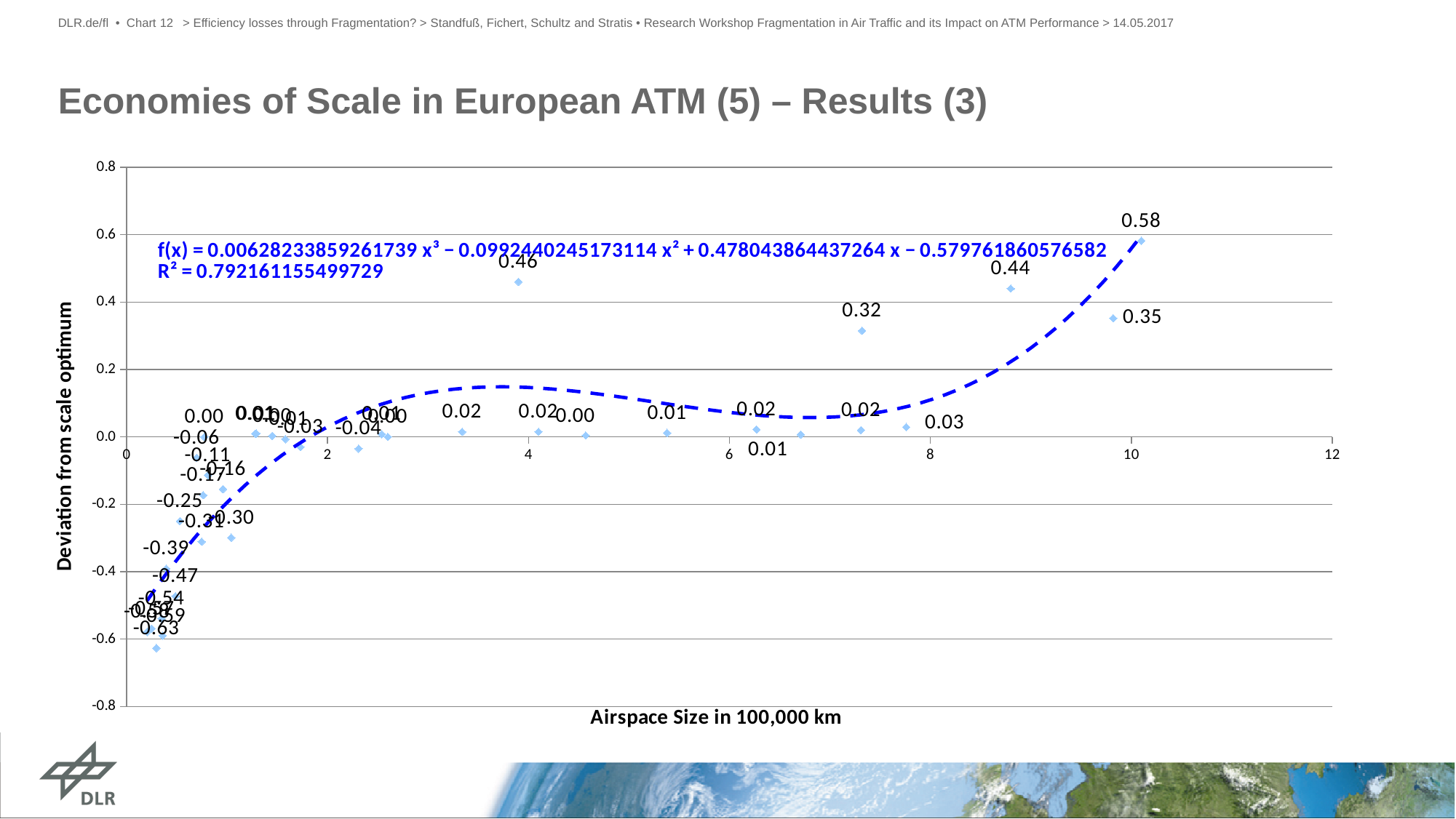
What is the difference between the points labelled 0.46 and 0.32? 0.14 What R² value is printed for the trendline? 0.792161155499729 Do the plotted values generally rise or fall as airspace size increases along the x axis? rise What is the maximum value shown on the y axis? 0.8 Is the value of the point labelled 0.32 greater or less than 0.2? greater What kind of chart is shown on the slide? Scatter chart What is the title of the x axis? Airspace Size in 100,000 km What is the highest data label value shown on the chart? 0.58 Which is larger: the point labelled 0.44 or the point labelled 0.35? 0.44 What is the difference between the highest labelled point (0.58) and the point labelled 0.44? 0.14 What is the lowest data label value shown on the chart? -0.63